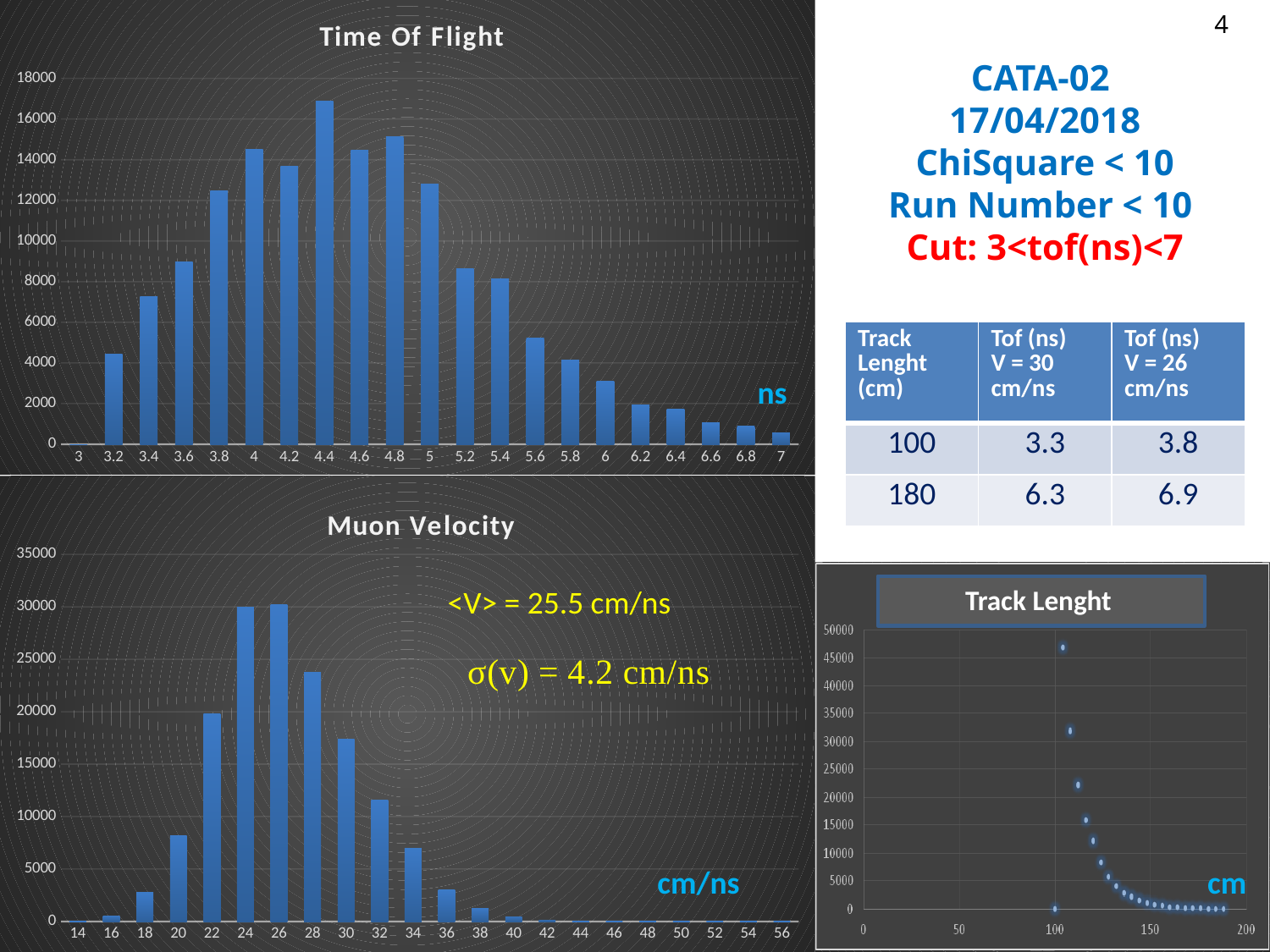
In the Track Lenght chart, do the values rise or fall as track length increases from 100 cm to 200 cm? fall In the Muon Velocity chart, is the value for 32 greater or less than 10000? greater In the Muon Velocity chart, is the value for 24 greater or less than 25000? greater In the Time Of Flight chart, is the value for 6.6 greater or less than 2000? less In the Time Of Flight chart, which bar is taller, 4.4 or 4.8? 4.4 What unit label is shown on the x axis of the Muon Velocity chart? cm/ns In the Muon Velocity chart, which bar is taller, 30 or 32? 30 In the Time Of Flight chart, which time-of-flight bin has the tallest bar? 4.4 What kind of chart is the Time Of Flight chart? bar chart What kind of chart is the Track Lenght chart? scatter chart